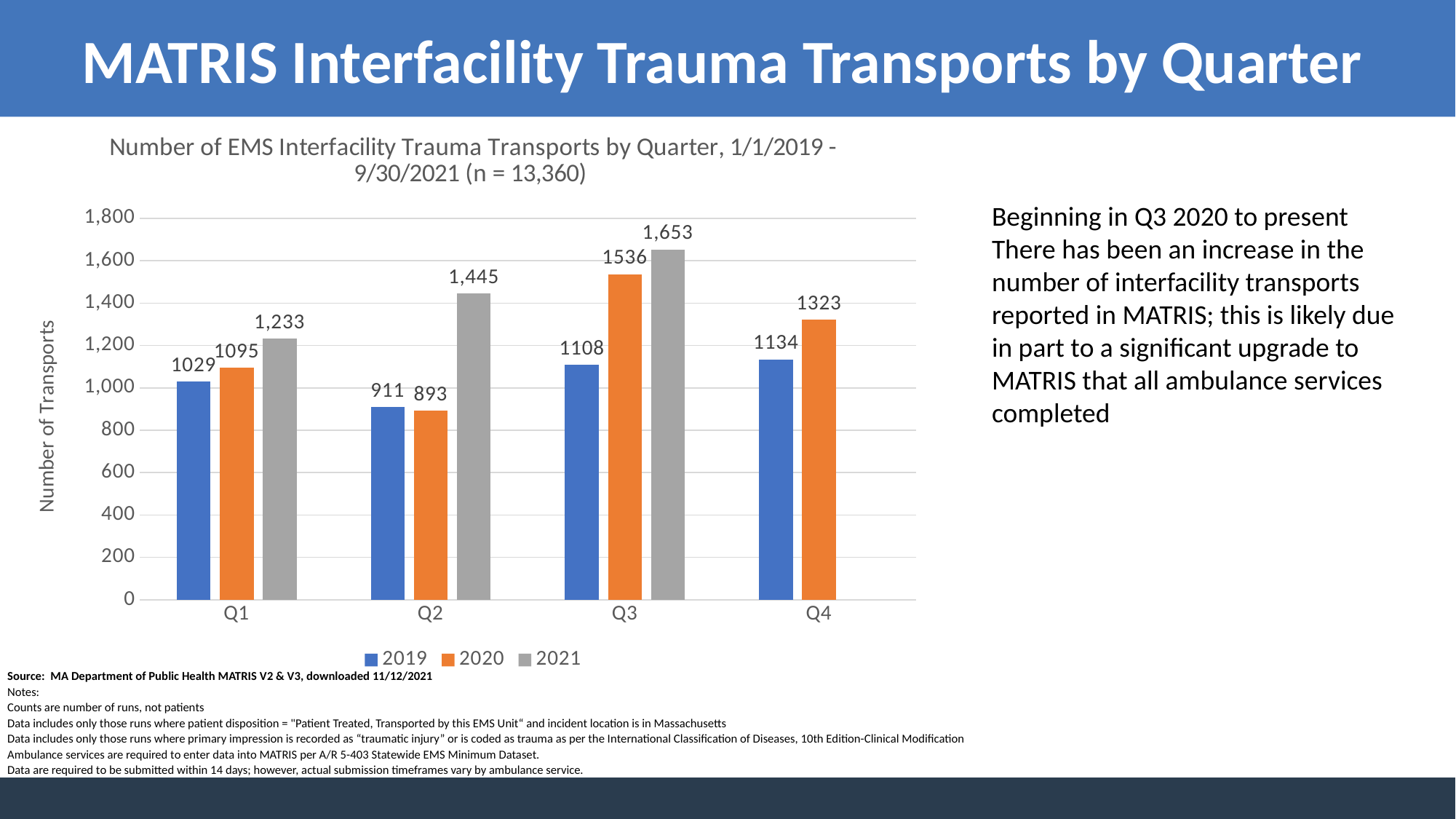
What is the number of transports for 2019 in Q2? 911 What is the number of transports for 2021 in Q3? 1,653 What is the difference between the 2021 and 2019 values in Q1? 204 Which quarter has the lowest value for the 2019 series? Q2 What kind of chart is shown on the slide? Bar chart Which is larger in Q2: the 2019 value or the 2020 value? 2019 What is the label of the vertical axis? Number of Transports How many series does the legend list? 3 What is the number of transports for 2020 in Q4? 1323 Is the value for 2021 in Q2 greater or less than 1,400? greater How many quarters are shown on the x axis? 4 Which quarter has the highest value for the 2020 series? Q3